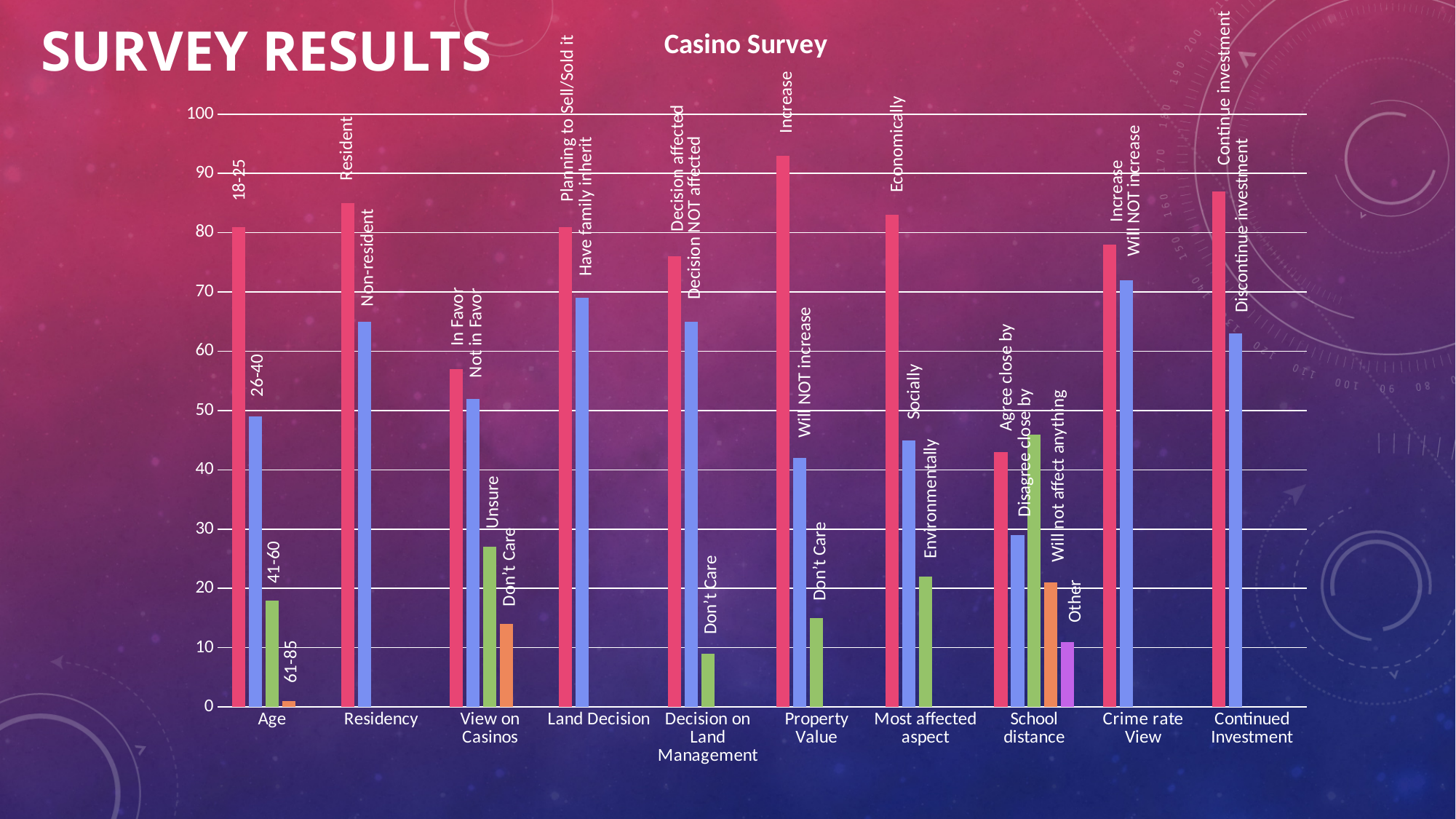
What kind of chart is shown on the slide? bar chart Which bar is the tallest in the Property Value category? Increase Which bar is the lowest in the Age category? 61-85 What is the title of the chart? Casino Survey Is the value for Non-resident in the Residency category greater or less than 60? greater How many survey categories are shown along the x axis? 10 How many bars are plotted in the School distance category? 5 Is the value for Don't Care in the Decision on Land Management category greater or less than 20? less In the Residency category, which is larger, Resident or Non-resident? Resident In the School distance category, which is larger, Agree close by or Disagree close by? Disagree close by Is the value for 18-25 in the Age category greater or less than 70? greater